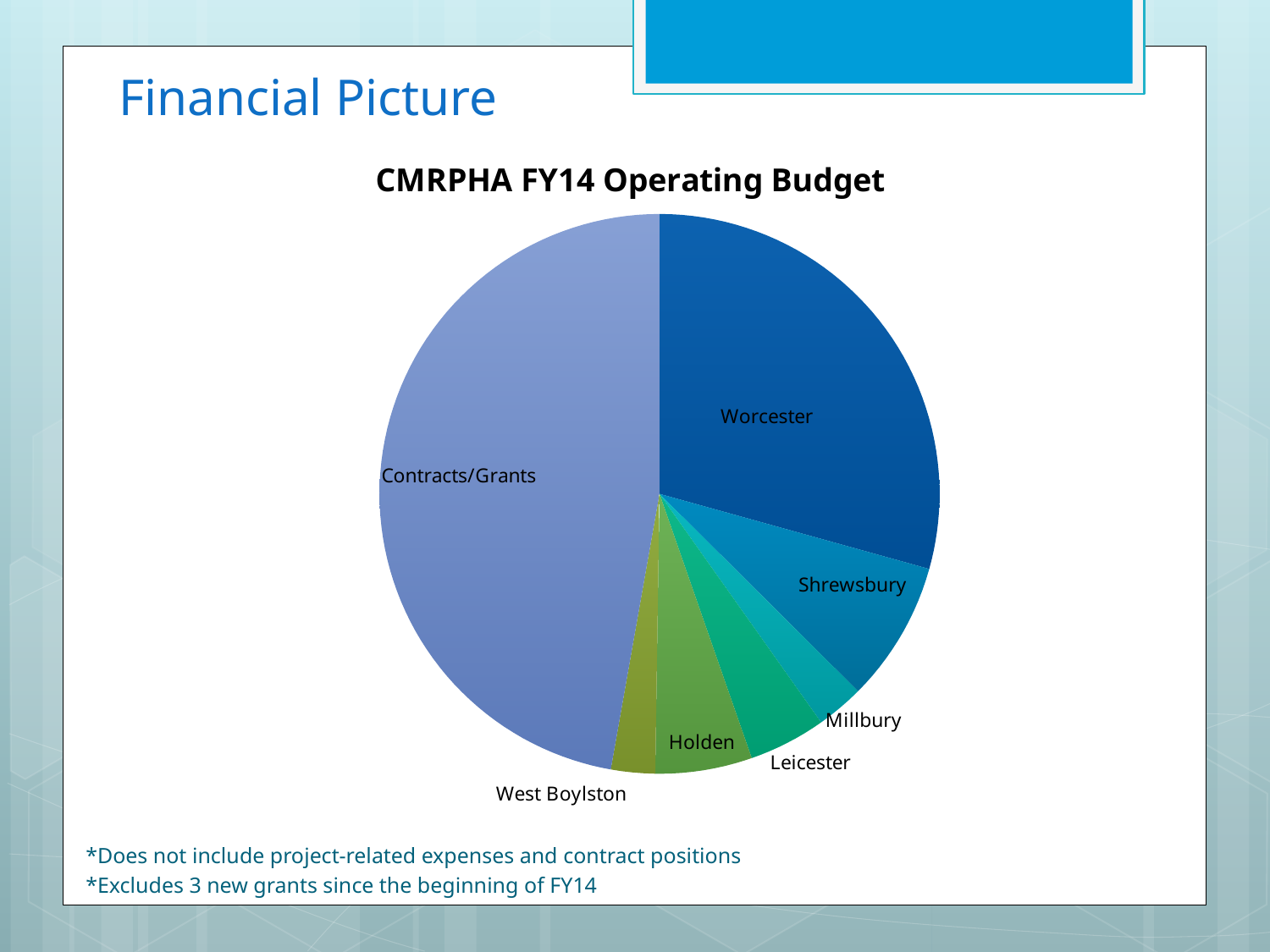
Which slice is larger, Shrewsbury or Millbury? Shrewsbury Which slice is larger, Holden or Worcester? Worcester What is the title of the chart? CMRPHA FY14 Operating Budget Which category has the largest slice of the pie? Contracts/Grants What kind of chart is shown on the slide? pie chart Which slice is larger, Contracts/Grants or Shrewsbury? Contracts/Grants Which municipality has the largest slice of the pie? Worcester According to the footnote, how many new grants since the beginning of FY14 are excluded from the chart? 3